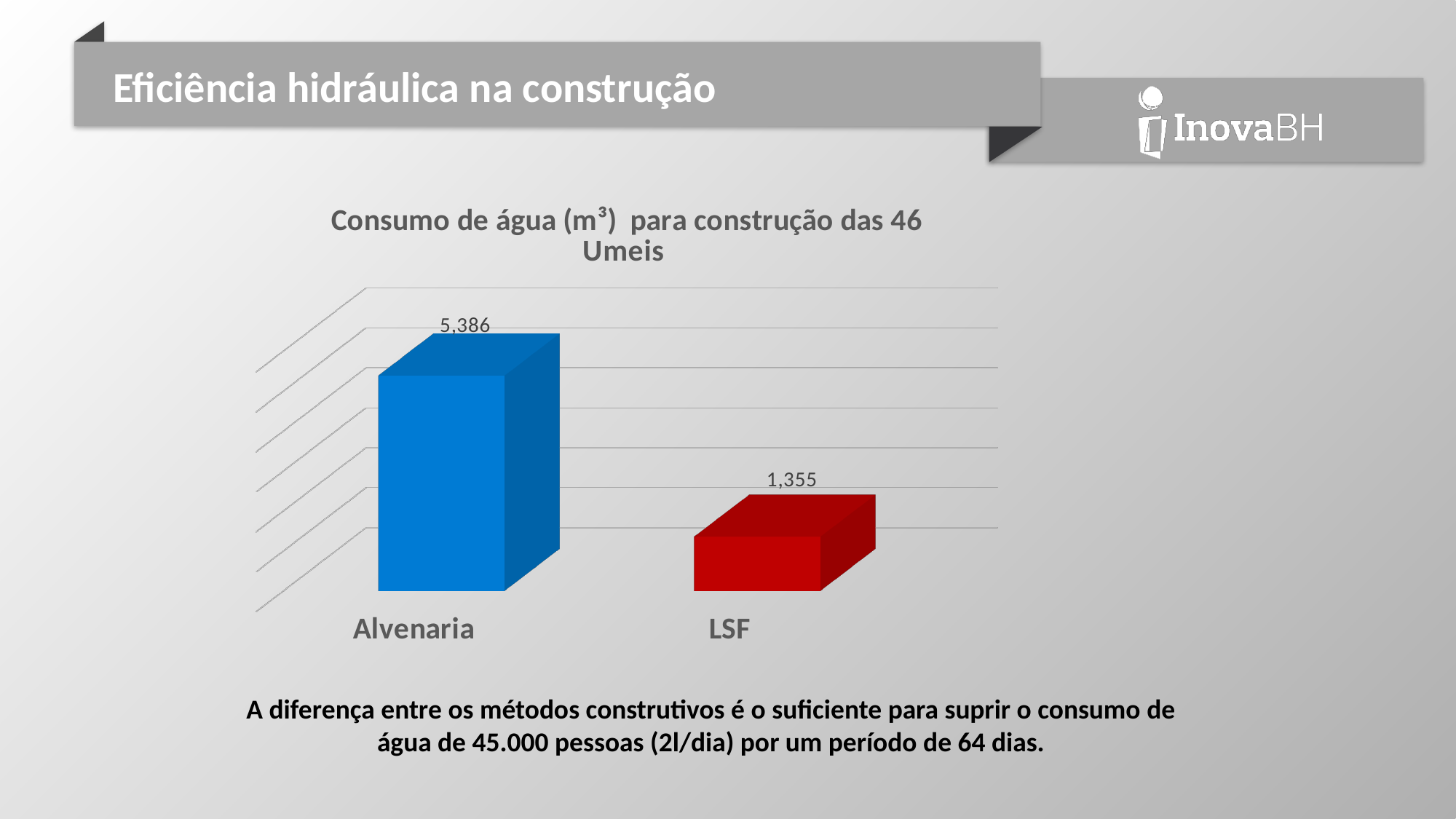
Which construction method has the highest water consumption in the chart? Alvenaria How many categories are plotted in the chart? 2 Which construction method has the lowest water consumption in the chart? LSF What is the difference between the water consumption of Alvenaria and LSF? 4,031 What is the water consumption value shown for Alvenaria? 5,386 What is the title of the chart? Consumo de água (m³) para construção das 46 Umeis What is the water consumption value shown for LSF? 1,355 What kind of chart is shown on the slide? Bar chart What colour is the bar for LSF? Red Which has a larger water consumption value, Alvenaria or LSF? Alvenaria